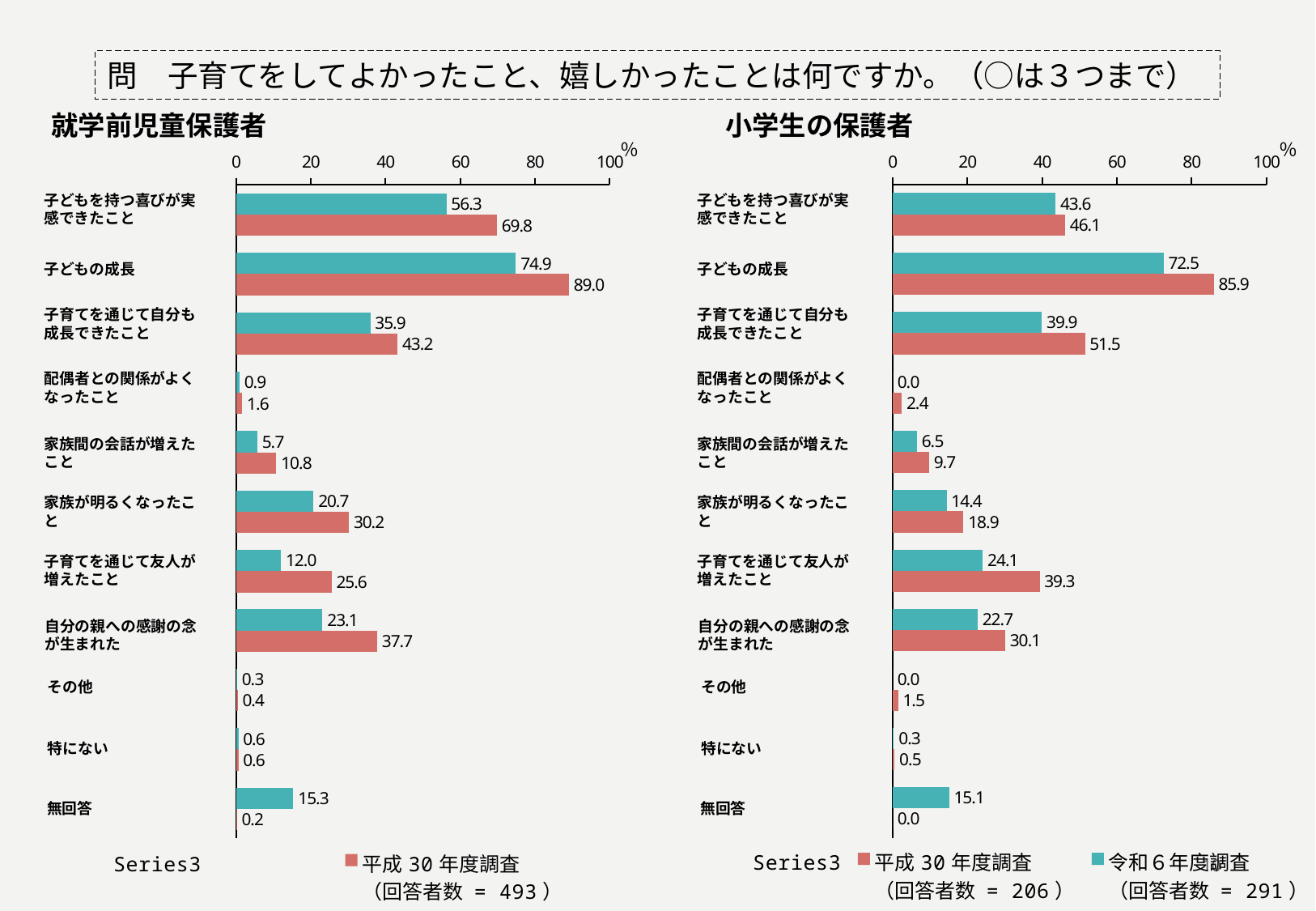
How many categories are listed in the 小学生の保護者 chart? 11 In the 小学生の保護者 chart, what is the difference between the 平成30年度調査 and 令和6年度調査 values for 子どもの成長? 13.4 According to the legend of the 小学生の保護者 chart, how many respondents were in the 令和6年度調査? 291 In the 小学生の保護者 chart, which category has the lowest 令和6年度調査 value? 配偶者との関係がよくなったこと and その他 (both 0.0) In the 小学生の保護者 chart, what is the 令和6年度調査 value for 子育てを通じて友人が増えたこと? 24.1 In the 小学生の保護者 chart, which is larger for 家族が明るくなったこと: the 平成30年度調査 value or the 令和6年度調査 value? 平成30年度調査 In the 就学前児童保護者 chart, is the 平成30年度調査 value for 子どもを持つ喜びが実感できたこと greater or less than 60? greater In the 就学前児童保護者 chart, which category has the highest 平成30年度調査 value? 子どもの成長 In the 就学前児童保護者 chart, what is the 平成30年度調査 value for 子どもの成長? 89.0 What type of chart is used for the 就学前児童保護者 data? bar chart In the 就学前児童保護者 chart, what is the difference between the 平成30年度調査 and the teal-bar values for 自分の親への感謝の念が生まれた? 14.6 In the 小学生の保護者 chart, what is the 平成30年度調査 value for 子育てを通じて自分も成長できたこと? 51.5